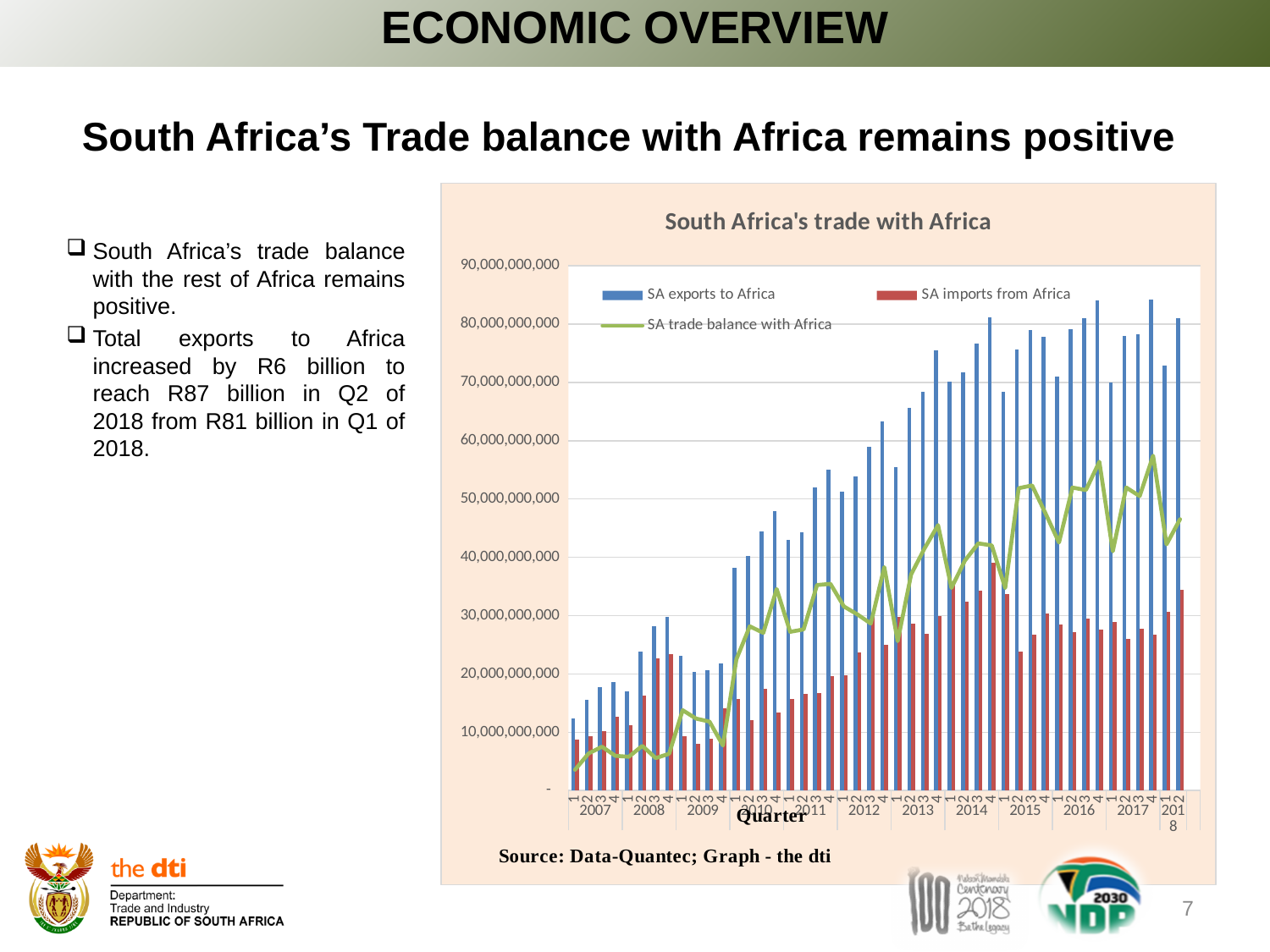
In quarter 2 of 2018, which is larger: SA exports to Africa or SA imports from Africa? SA exports to Africa Is the value of SA exports to Africa in quarter 1 of 2007 greater or less than 20,000,000,000? less Overall, do SA exports to Africa rise or fall from 2007 to 2018? rise Which series in the chart is drawn as a line rather than bars? SA trade balance with Africa Is the SA trade balance with Africa in quarter 4 of 2017 greater or less than 50,000,000,000? greater Is the value of SA imports from Africa in quarter 2 of 2018 greater or less than 40,000,000,000? less How many years are labelled along the x axis of the chart? 12 In which quarter is SA exports to Africa at its lowest? Quarter 1 of 2007 What is the title of the chart? South Africa's trade with Africa How many series does the chart's legend list? 3 What is the label of the x axis of the chart? Quarter